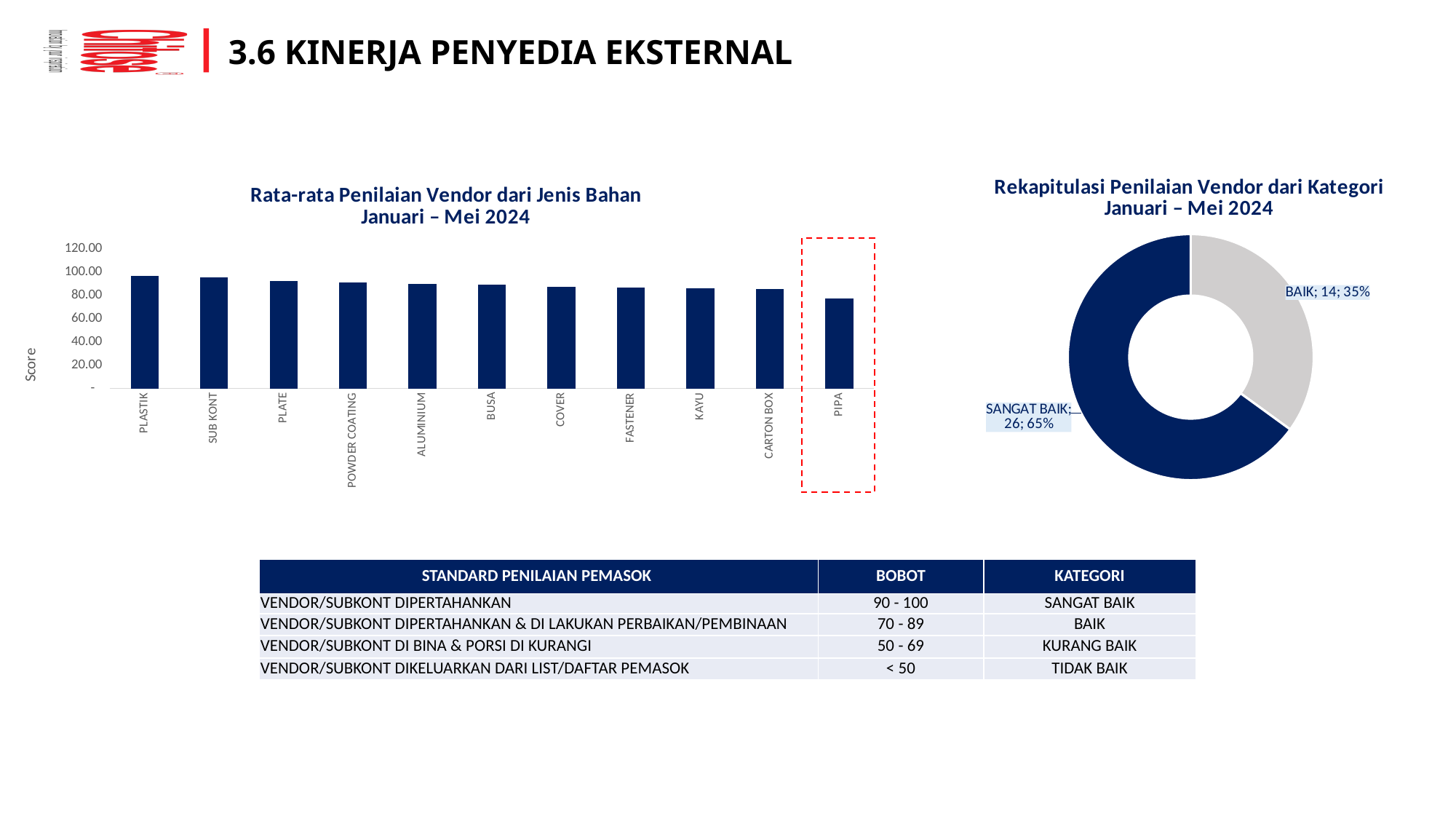
What kind of chart is 'Rata-rata Penilaian Vendor dari Jenis Bahan Januari – Mei 2024'? Bar chart In the chart 'Rekapitulasi Penilaian Vendor dari Kategori Januari – Mei 2024', what is the total number of vendors across both categories? 40 In the chart 'Rata-rata Penilaian Vendor dari Jenis Bahan Januari – Mei 2024', is the value for PIPA greater or less than 80.00? less How many material types are shown in the chart 'Rata-rata Penilaian Vendor dari Jenis Bahan Januari – Mei 2024'? 11 In the chart 'Rata-rata Penilaian Vendor dari Jenis Bahan Januari – Mei 2024', is the value for PLASTIK greater or less than 80.00? greater In the chart 'Rekapitulasi Penilaian Vendor dari Kategori Januari – Mei 2024', what share of vendors are in the BAIK category? 35% In the chart 'Rata-rata Penilaian Vendor dari Jenis Bahan Januari – Mei 2024', which material type has the highest average score? PLASTIK In the chart 'Rekapitulasi Penilaian Vendor dari Kategori Januari – Mei 2024', what is the difference between the number of SANGAT BAIK vendors and BAIK vendors? 12 In the chart 'Rata-rata Penilaian Vendor dari Jenis Bahan Januari – Mei 2024', do the values rise or fall from left to right? Fall In the chart 'Rata-rata Penilaian Vendor dari Jenis Bahan Januari – Mei 2024', which is larger, the value for SUB KONT or the value for KAYU? SUB KONT In the chart 'Rata-rata Penilaian Vendor dari Jenis Bahan Januari – Mei 2024', which material type has the lowest average score? PIPA In the chart 'Rekapitulasi Penilaian Vendor dari Kategori Januari – Mei 2024', how many vendors are in the SANGAT BAIK category? 26